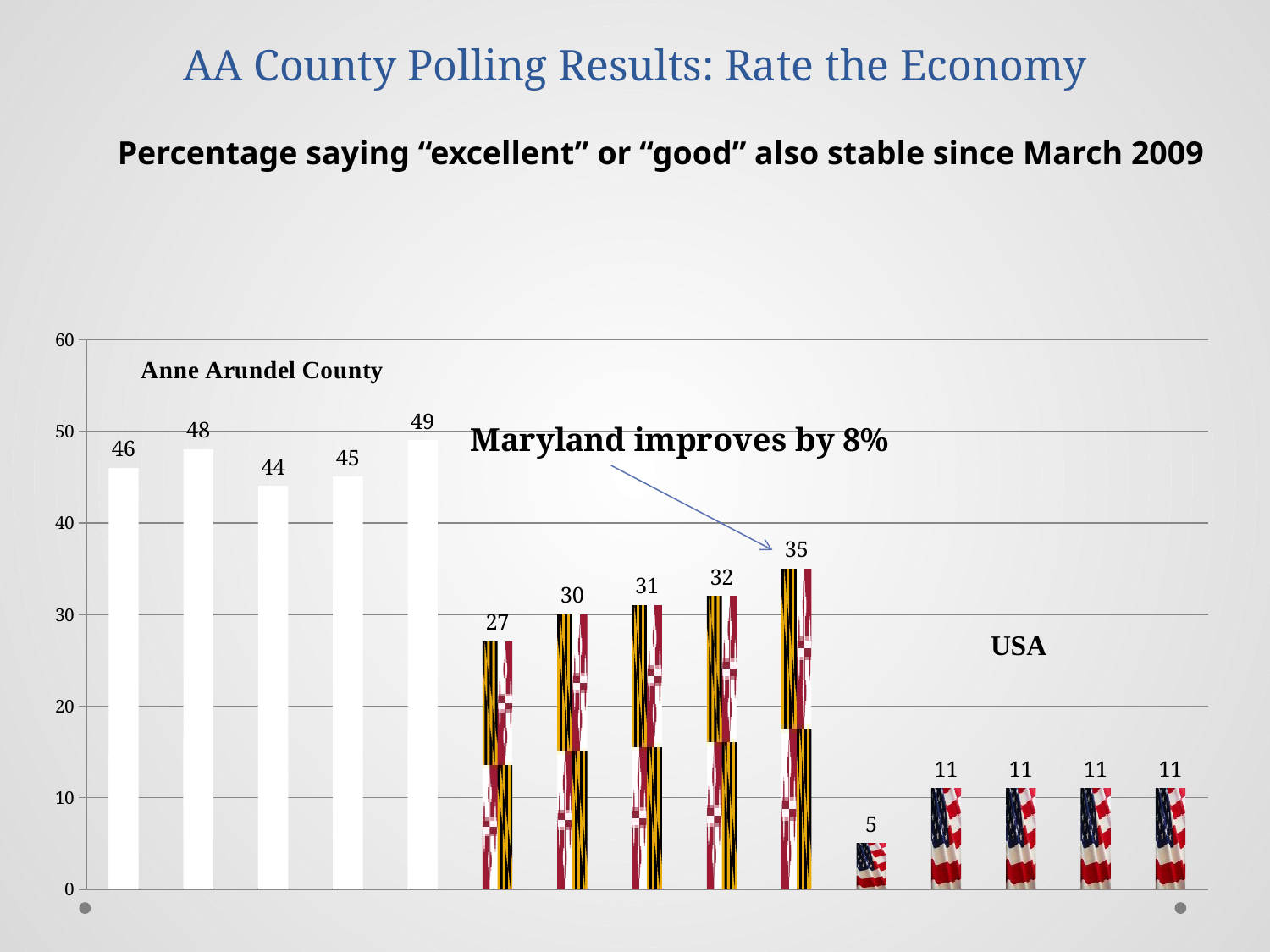
What is the value of the first (leftmost) bar in the USA group? 5 What is the value of the first (leftmost) bar in the Maryland group? 27 Do the values in the Maryland group rise or fall from left to right? rise What is the value of the highest bar in the Anne Arundel County group? 49 What is the value of the last (rightmost) bar in the Maryland group? 35 How many bars are plotted in total on the chart? 15 What type of chart is shown on the slide? bar chart Which is larger: the second bar in the Anne Arundel County group or the second bar in the Maryland group? Anne Arundel County (48) What is the difference between the last and first bars in the Maryland group? 8 What is the maximum value shown on the vertical axis? 60 What is the value of the lowest bar in the Anne Arundel County group? 44 What is the difference between the highest Anne Arundel County bar and the highest Maryland bar? 14